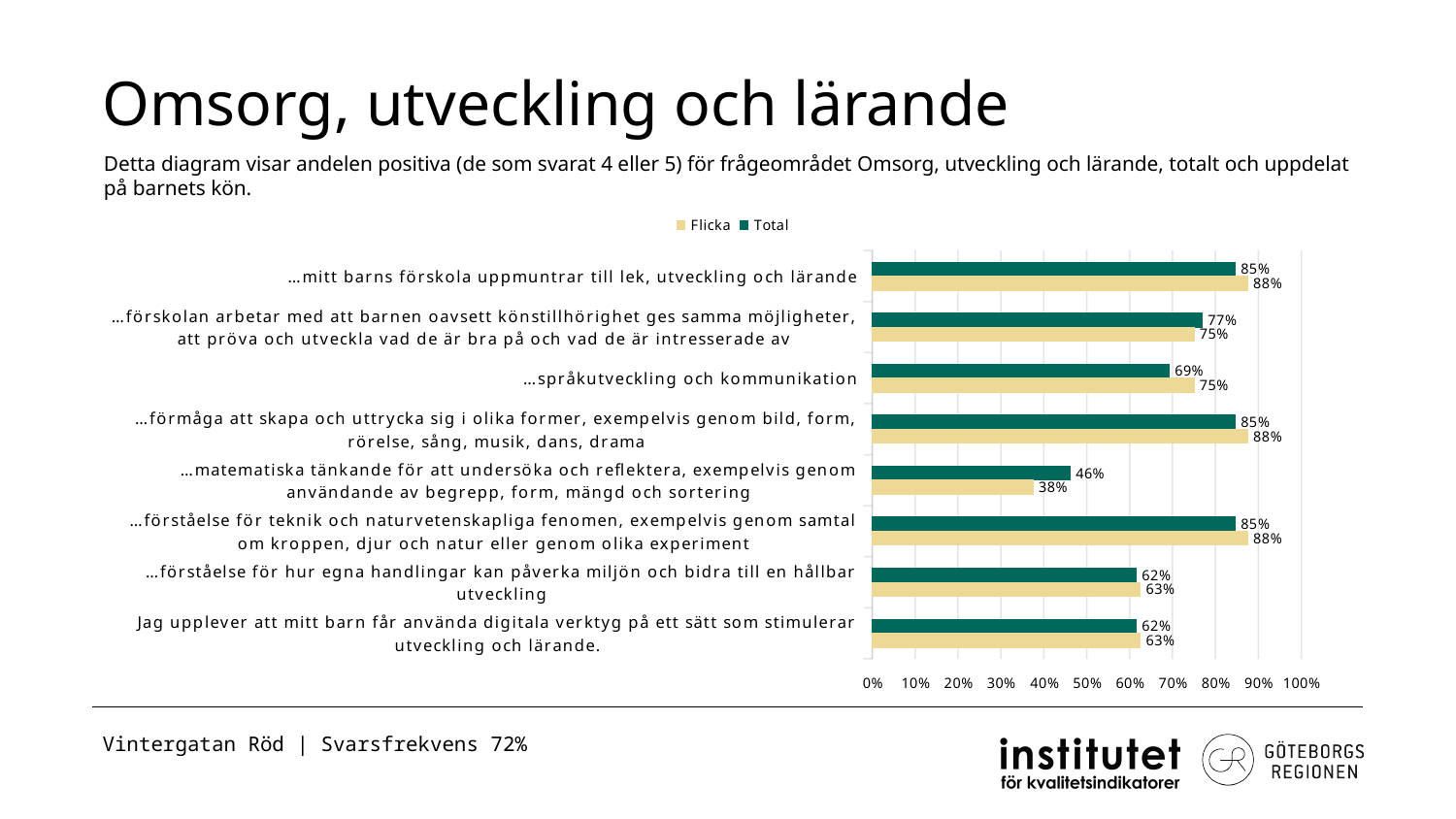
Which series is shown in green in the chart? Total How many series does the legend list? 2 What is the difference between the Flicka and Total values for "…språkutveckling och kommunikation"? 6 percentage points For "…matematiska tänkande för att undersöka och reflektera", which is larger, the Flicka value or the Total value? Total Which category has the lowest Total value? …matematiska tänkande för att undersöka och reflektera, exempelvis genom användande av begrepp, form, mängd och sortering What is the Total value for "…förskolan arbetar med att barnen oavsett könstillhörighet ges samma möjligheter, att pröva och utveckla vad de är bra på och vad de är intresserade av"? 77% Is the Total value for "…förståelse för hur egna handlingar kan påverka miljön och bidra till en hållbar utveckling" greater or less than 70%? less What is the Total value for "…språkutveckling och kommunikation"? 69% What is the Flicka value for "…matematiska tänkande för att undersöka och reflektera, exempelvis genom användande av begrepp, form, mängd och sortering"? 38% What is the Flicka value for "Jag upplever att mitt barn får använda digitala verktyg på ett sätt som stimulerar utveckling och lärande."? 63% How many categories (statements) are plotted in the chart? 8 What kind of chart is shown on the slide? bar chart